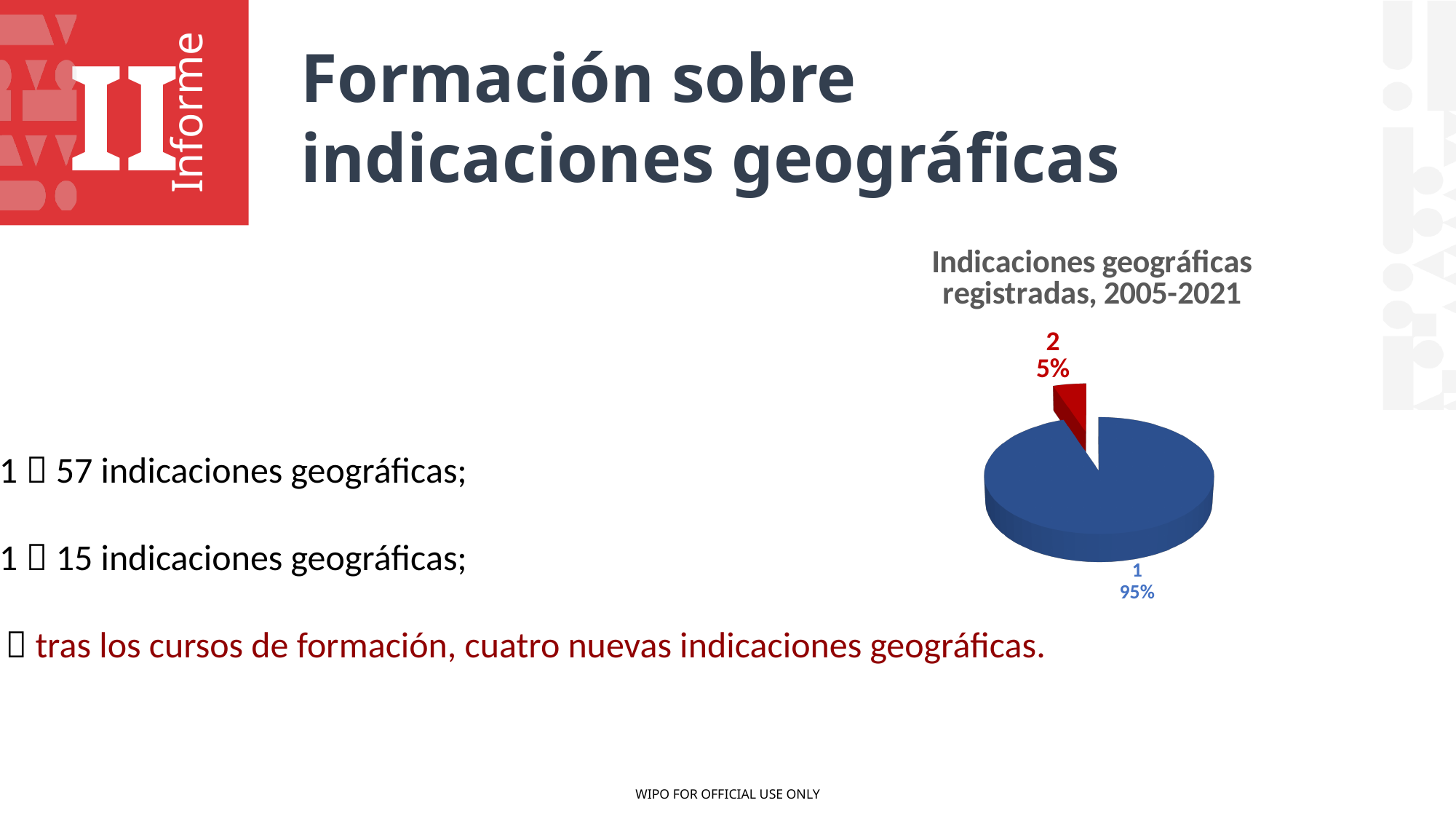
What kind of chart is shown on the slide? pie chart Which slice is the largest in the pie chart? 1 What is the difference in percentage points between slice 1 and slice 2? 90 percentage points What share of the pie does slice 1 represent? 95% What share of the pie does slice 2 represent? 5% How many slices does the pie chart have? 2 What is the title of the chart? Indicaciones geográficas registradas, 2005-2021 What period does the chart title cover? 2005-2021 What colour is the slice labelled 2? red Which slice is the smallest in the pie chart? 2 Which slice is larger, 1 or 2? 1